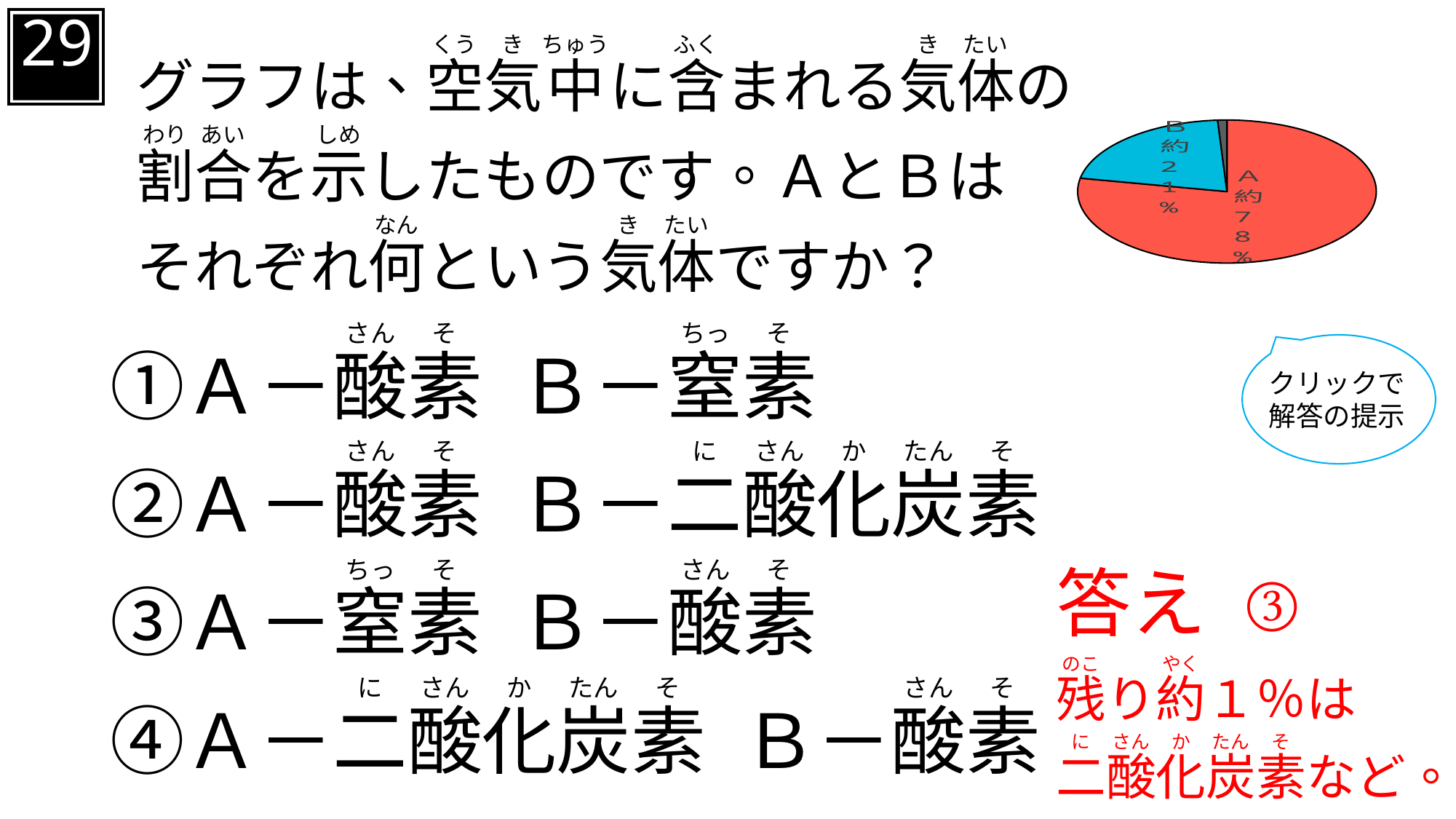
How many slices does the pie chart have? 3 What colour is slice A in the pie chart? red What kind of chart is shown on the slide? pie chart What colour is slice B in the pie chart? blue Is the share of slice A in the pie chart greater or less than 50%? greater What percentage is shown for slice B in the pie chart? 約21% What percentage is shown for slice A in the pie chart? 約78% Is the share of slice B in the pie chart greater or less than 50%? less Which labeled slice of the pie chart is the largest? A Which is larger in the pie chart, slice A or slice B? A